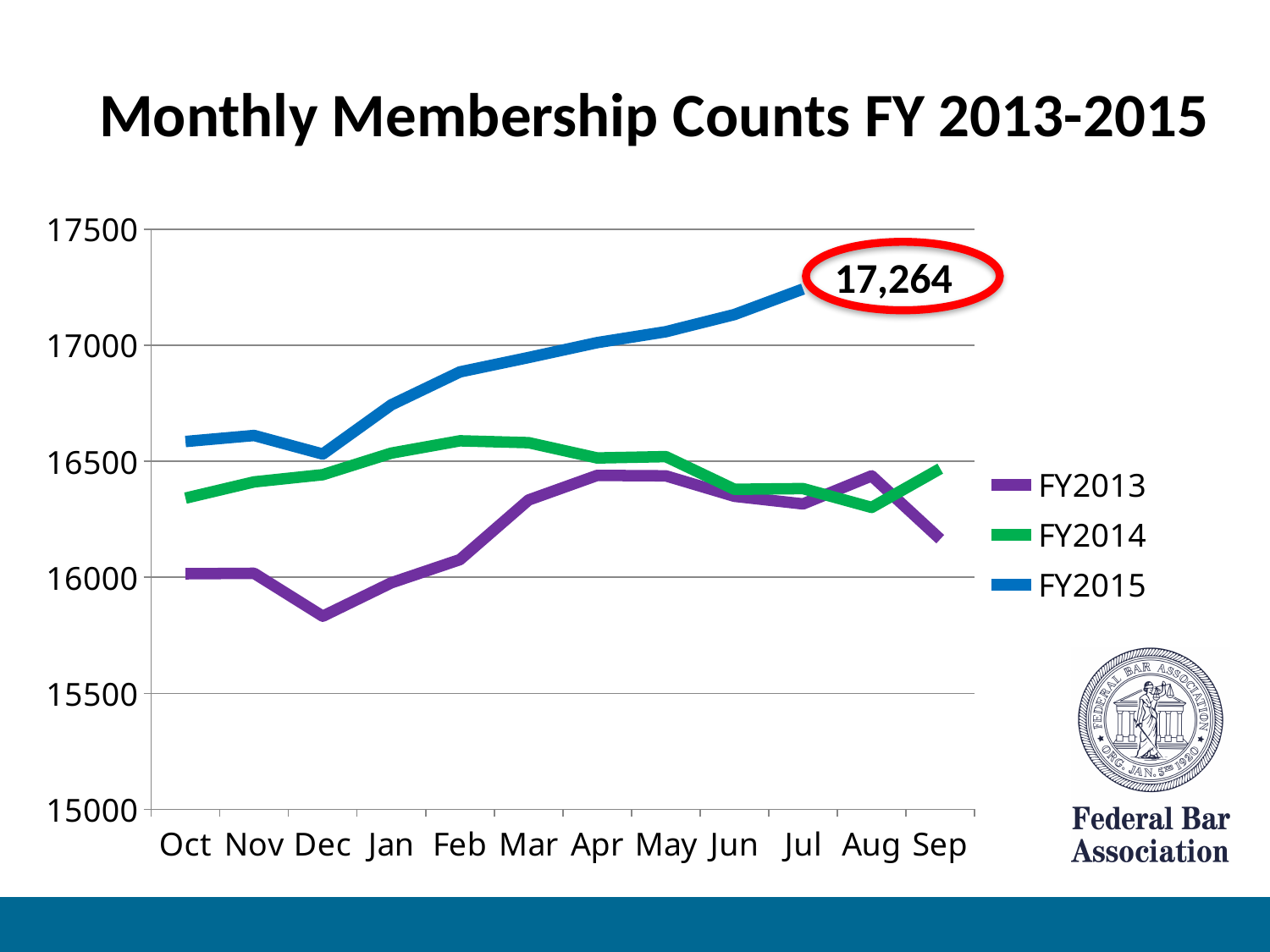
How many months are shown along the x axis? 12 In Jan, which series has the higher value, FY2013 or FY2015? FY2015 What kind of chart is shown on the slide? line chart Which series has the highest value in Jul? FY2015 How many series does the legend list? 3 What is the labelled FY2015 membership count for Jul? 17,264 Is the FY2013 value for Dec greater or less than 16000? less Does the FY2015 line rise or fall from Dec to Jul? rise In which month does the FY2013 line reach its lowest value? Dec What is the title of the chart? Monthly Membership Counts FY 2013-2015 Is the FY2015 value for Feb greater or less than 16500? greater Is the FY2014 value for Oct greater or less than 16500? less